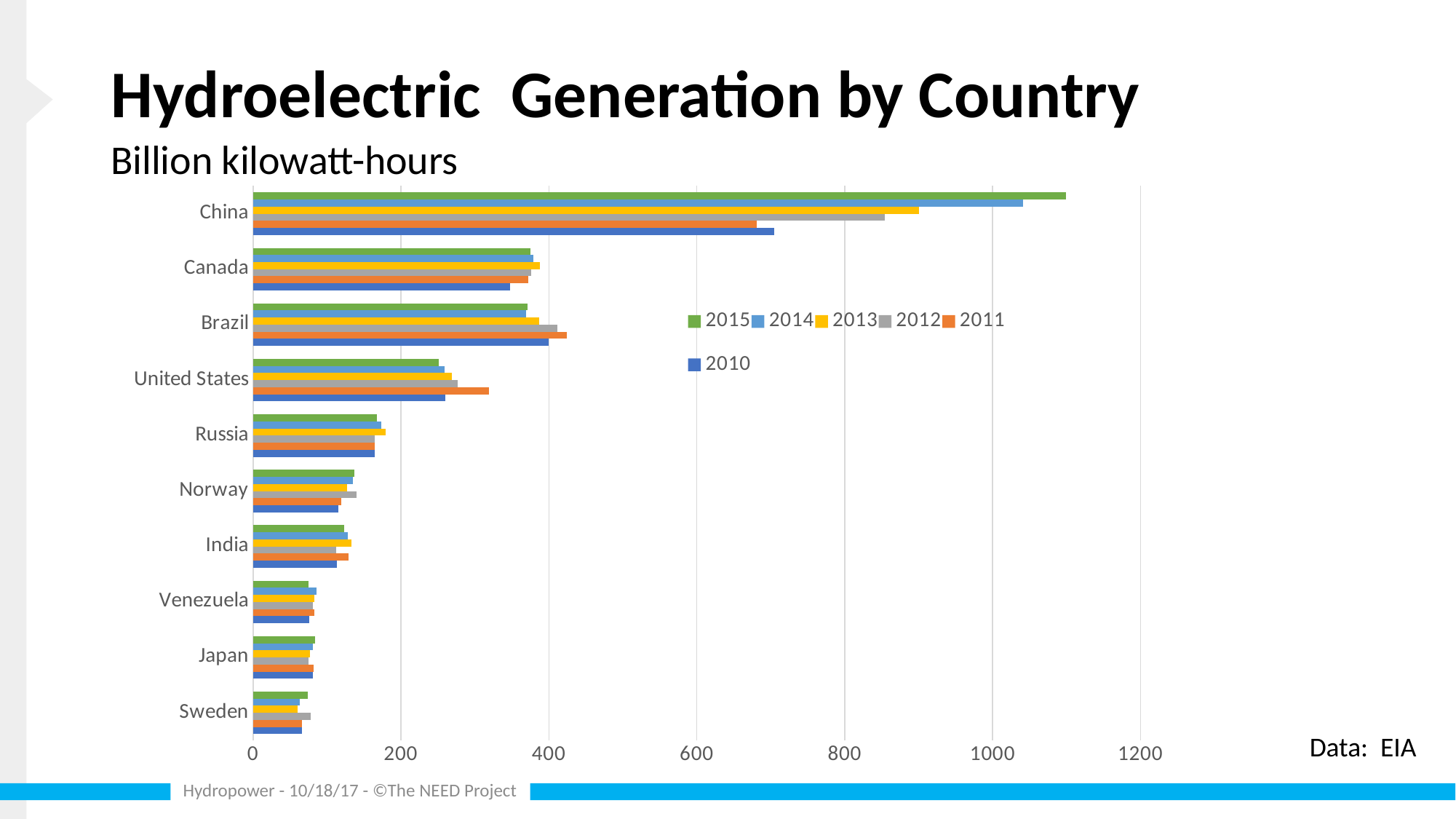
Which country has the lowest hydroelectric generation in 2010? Sweden For the United States, which year has the larger value: 2011 or 2015? 2011 For China, which year has the larger value: 2015 or 2010? 2015 Is the value for China in 2015 greater or less than 1000? greater Which country has the highest hydroelectric generation in 2015? China How many countries are shown on the chart? 10 Is the value for Russia in 2015 greater or less than 200? less What kind of chart is shown on the slide? Bar chart How many years (series) does the legend list? 6 Is the value for Canada in 2015 greater or less than 400? less What unit is the chart measured in, according to the subtitle? Billion kilowatt-hours